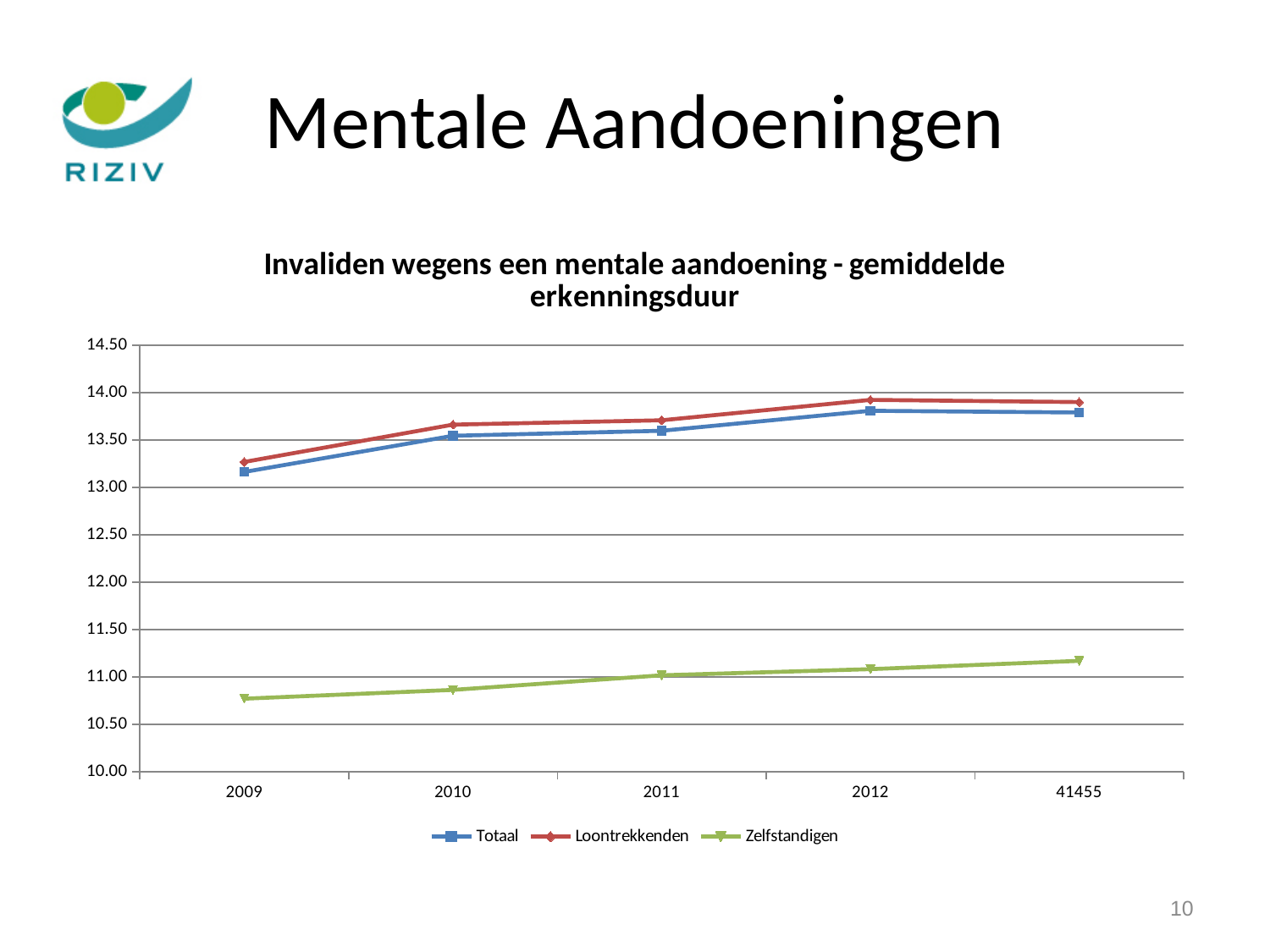
Is the value for Zelfstandigen in 2009 greater or less than 11.00? less How many series does the legend list? 3 What kind of chart is shown on the slide? line chart Is the value for Loontrekkenden in 2012 greater or less than 14.00? less What is the title of the chart? Invaliden wegens een mentale aandoening - gemiddelde erkenningsduur Does the Zelfstandigen series rise or fall from 2009 to 41455? rise Which series has the lowest values across all years? Zelfstandigen Is the value for Totaal in 2009 greater or less than 13.00? greater Which is larger in 2011, the value for Loontrekkenden or the value for Zelfstandigen? Loontrekkenden In which year does the Zelfstandigen series reach its lowest value? 2009 How many points are plotted along the x axis for each series? 5 Which series has the highest values across all years? Loontrekkenden